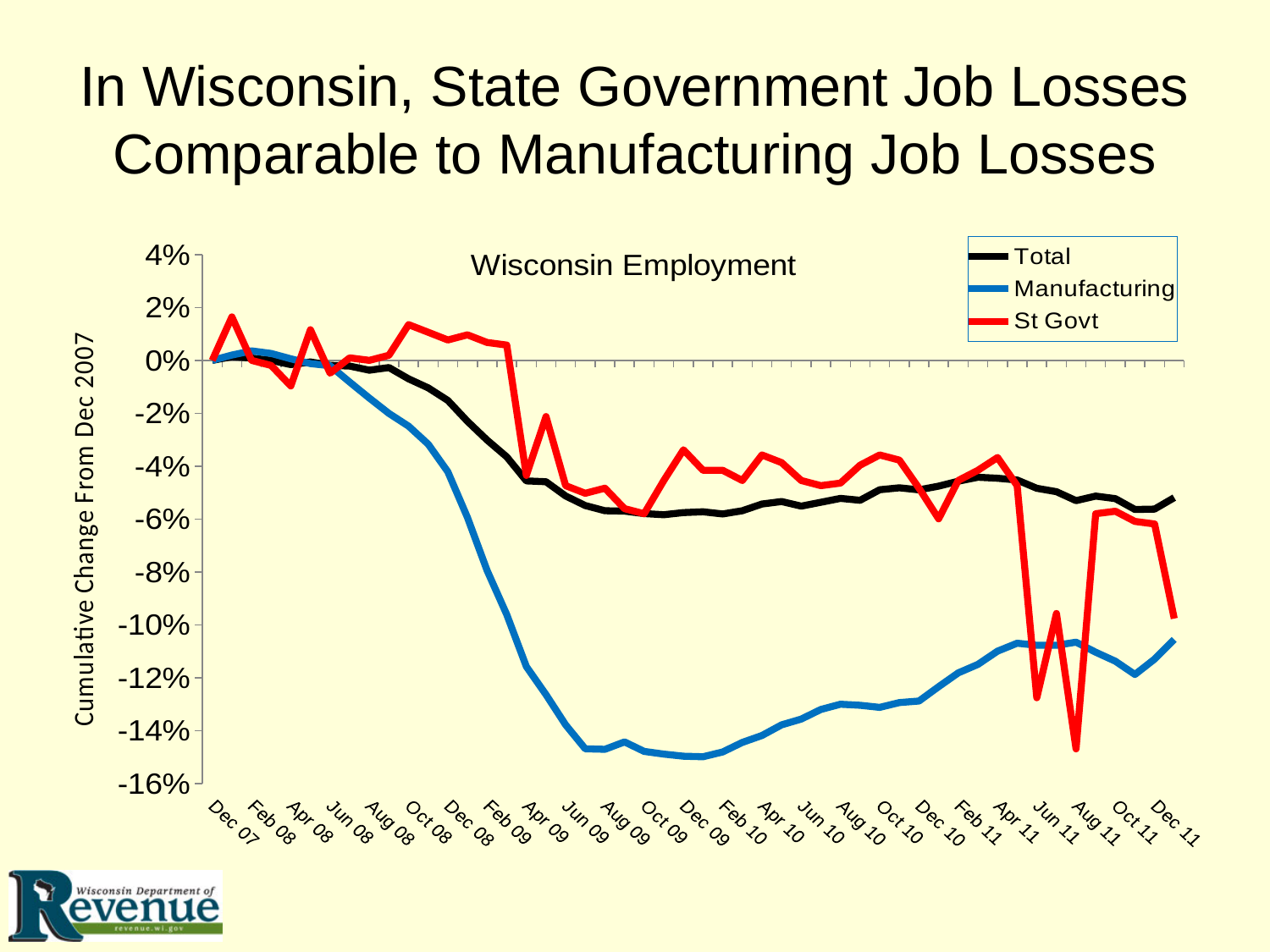
Does the Manufacturing series rise or fall between Dec 09 and Dec 11? Rise What is the title of the chart on the slide? Wisconsin Employment Which series reaches the lowest cumulative change in the Wisconsin Employment chart? Manufacturing At Dec 09, which series is lower, Total or Manufacturing? Manufacturing Which series in the Wisconsin Employment chart is drawn in red? St Govt Does the Manufacturing series rise or fall between Dec 07 and Dec 09? Fall Is the St Govt value at Jun 11 greater or less than -10%? less Is the Total value at Dec 09 greater or less than -4%? less What kind of chart is shown on the slide? Line chart Is the Manufacturing value at Dec 09 greater or less than -14%? less How many series does the legend of the Wisconsin Employment chart list? 3